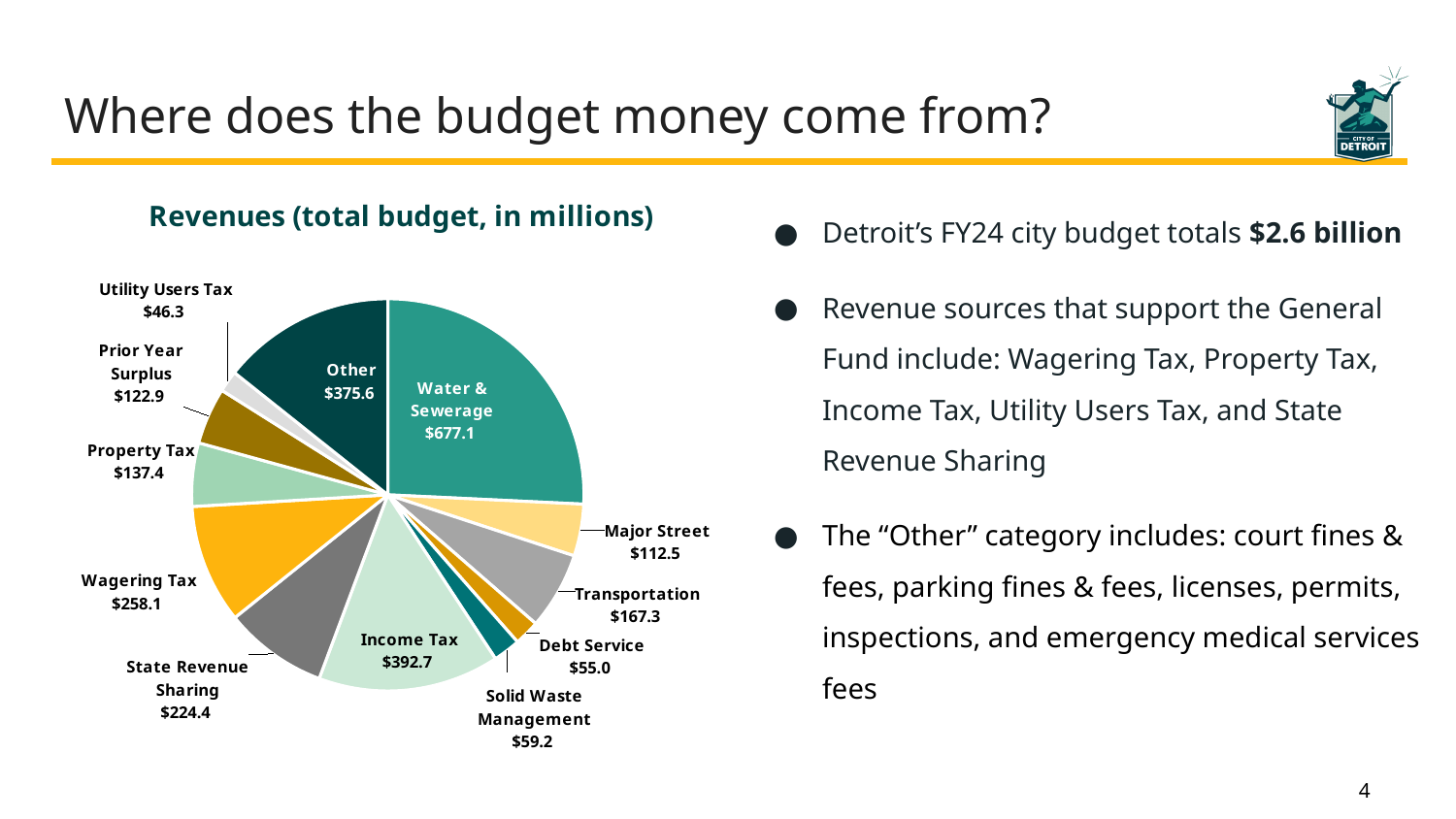
Which revenue source is the smallest slice of the pie? Utility Users Tax What type of chart is shown on the slide? Pie chart Which is larger, Transportation or Major Street? Transportation What is the value for Water & Sewerage? $677.1 What is the difference between Wagering Tax and State Revenue Sharing? $33.7 What is the value for Debt Service? $55.0 What is the value for State Revenue Sharing? $224.4 What is the difference between Water & Sewerage and Income Tax? $284.4 Which is larger, Income Tax or Other? Income Tax How many slices does the pie chart have? 12 What is the title of the chart? Revenues (total budget, in millions) Which revenue source is the largest slice of the pie? Water & Sewerage